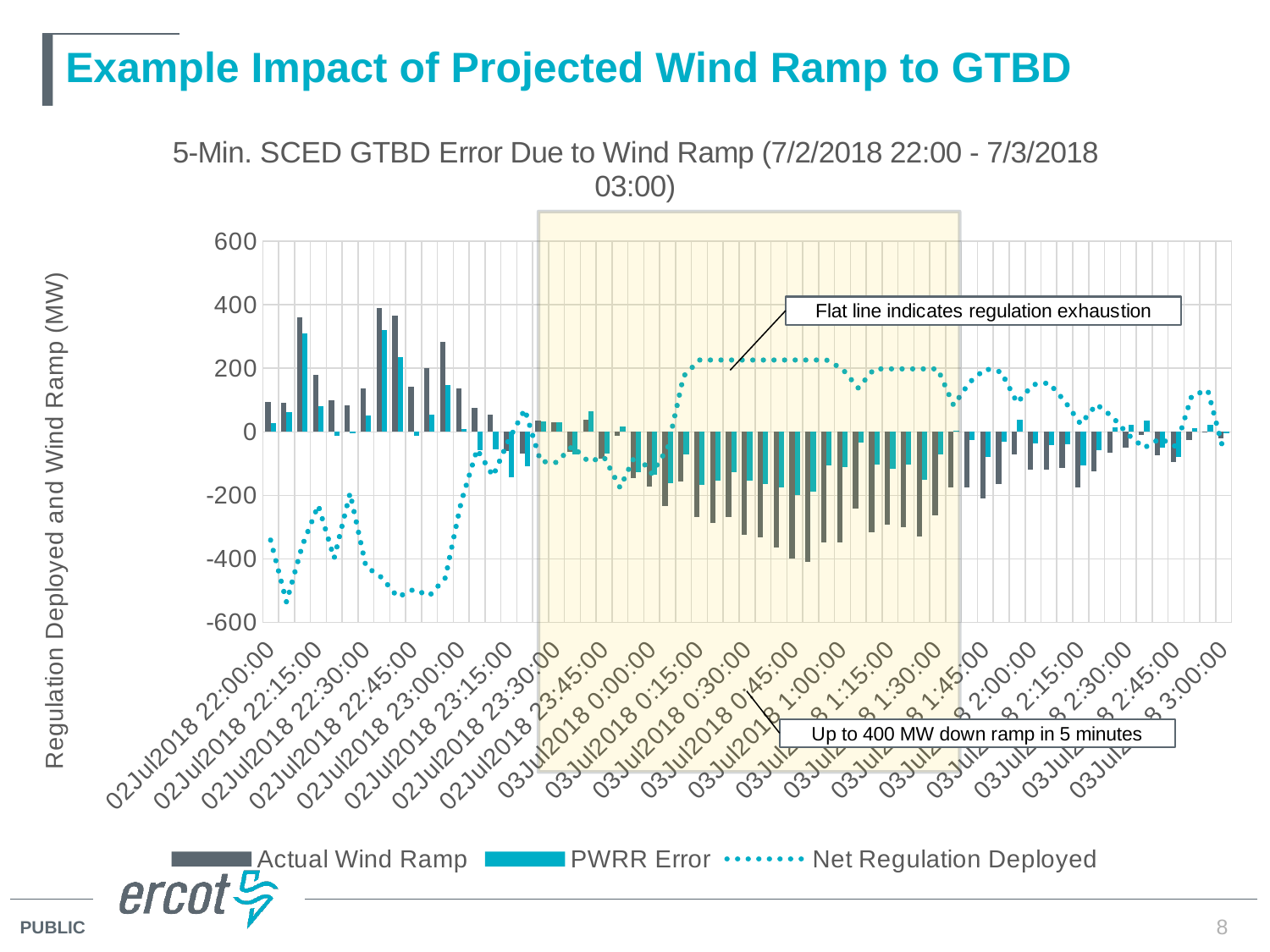
Is the Net Regulation Deployed value at 02Jul2018 22:00:00 greater or less than 0? less What kind of chart is shown on the slide? A combined bar and line chart Is the Net Regulation Deployed value at 03Jul2018 0:30:00 greater or less than 100? greater Does the Net Regulation Deployed line rise or fall between 02Jul2018 23:15:00 and 03Jul2018 0:15:00? rise Is the Actual Wind Ramp value at 02Jul2018 22:45:00 greater or less than 200? less What is the highest value shown on the y axis? 600 Which series is drawn as a dotted line? Net Regulation Deployed How many series does the legend list? 3 What is the title of the chart? 5-Min. SCED GTBD Error Due to Wind Ramp (7/2/2018 22:00 - 7/3/2018 03:00)